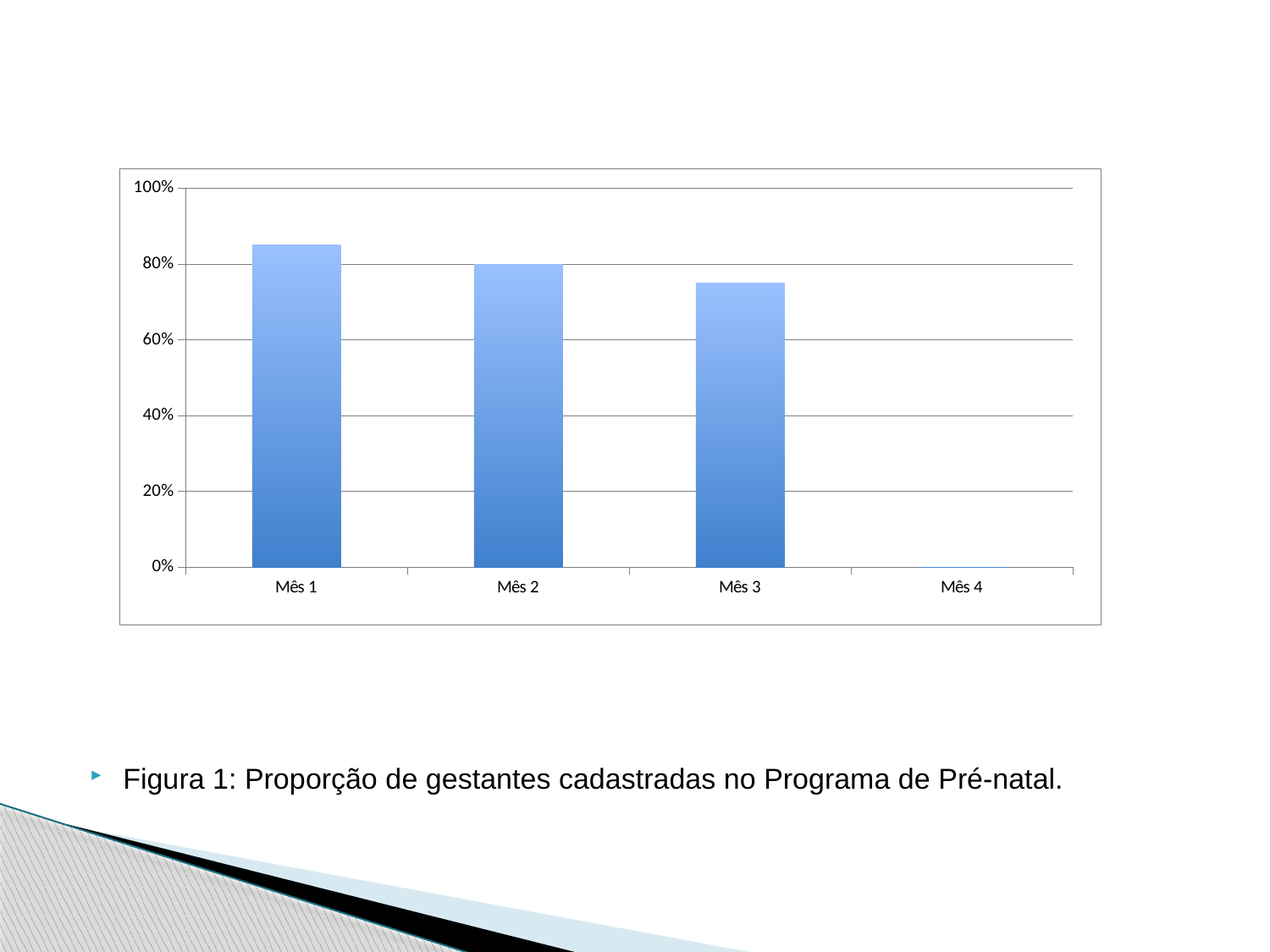
Which month has the lowest value? Mês 4 Which is larger, the value for Mês 2 or the value for Mês 3? Mês 2 What is the value for Mês 2? 80% How many categories are plotted on the x axis? 4 Which month has the highest value? Mês 1 Which is larger, the value for Mês 1 or the value for Mês 3? Mês 1 Is the value for Mês 3 greater or less than 80%? less Is the value for Mês 1 greater or less than 80%? greater What is the caption given for the figure on the slide? Figura 1: Proporção de gestantes cadastradas no Programa de Pré-natal. What kind of chart is shown on the slide? bar chart Is the value for Mês 4 greater or less than 20%? less Do the values rise or fall from Mês 1 to Mês 4? fall